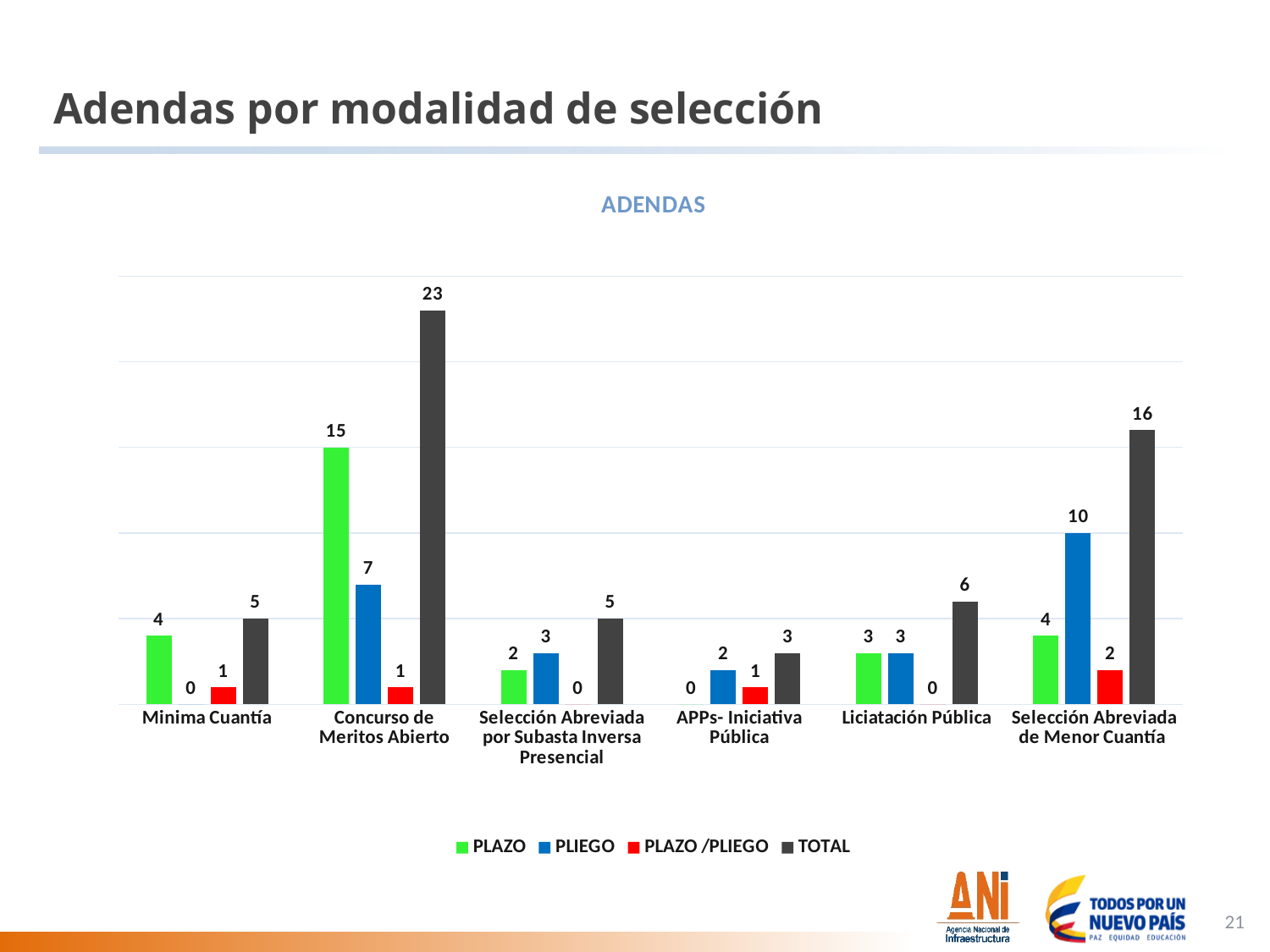
What is the title of the chart? ADENDAS What is the TOTAL value for Concurso de Meritos Abierto? 23 Which category has the lowest TOTAL value? APPs- Iniciativa Pública What kind of chart is shown? Bar chart What is the PLIEGO value for Selección Abreviada de Menor Cuantía? 10 How many categories are shown on the x axis? 6 What is the PLAZO value for Minima Cuantía? 4 What is the difference between the TOTAL values for Concurso de Meritos Abierto and Selección Abreviada de Menor Cuantía? 7 Which category has the highest TOTAL value? Concurso de Meritos Abierto How many series does the legend list? 4 What is the PLAZO /PLIEGO value for APPs- Iniciativa Pública? 1 Which is larger, the PLAZO value for Concurso de Meritos Abierto or the PLIEGO value for Selección Abreviada de Menor Cuantía? PLAZO value for Concurso de Meritos Abierto